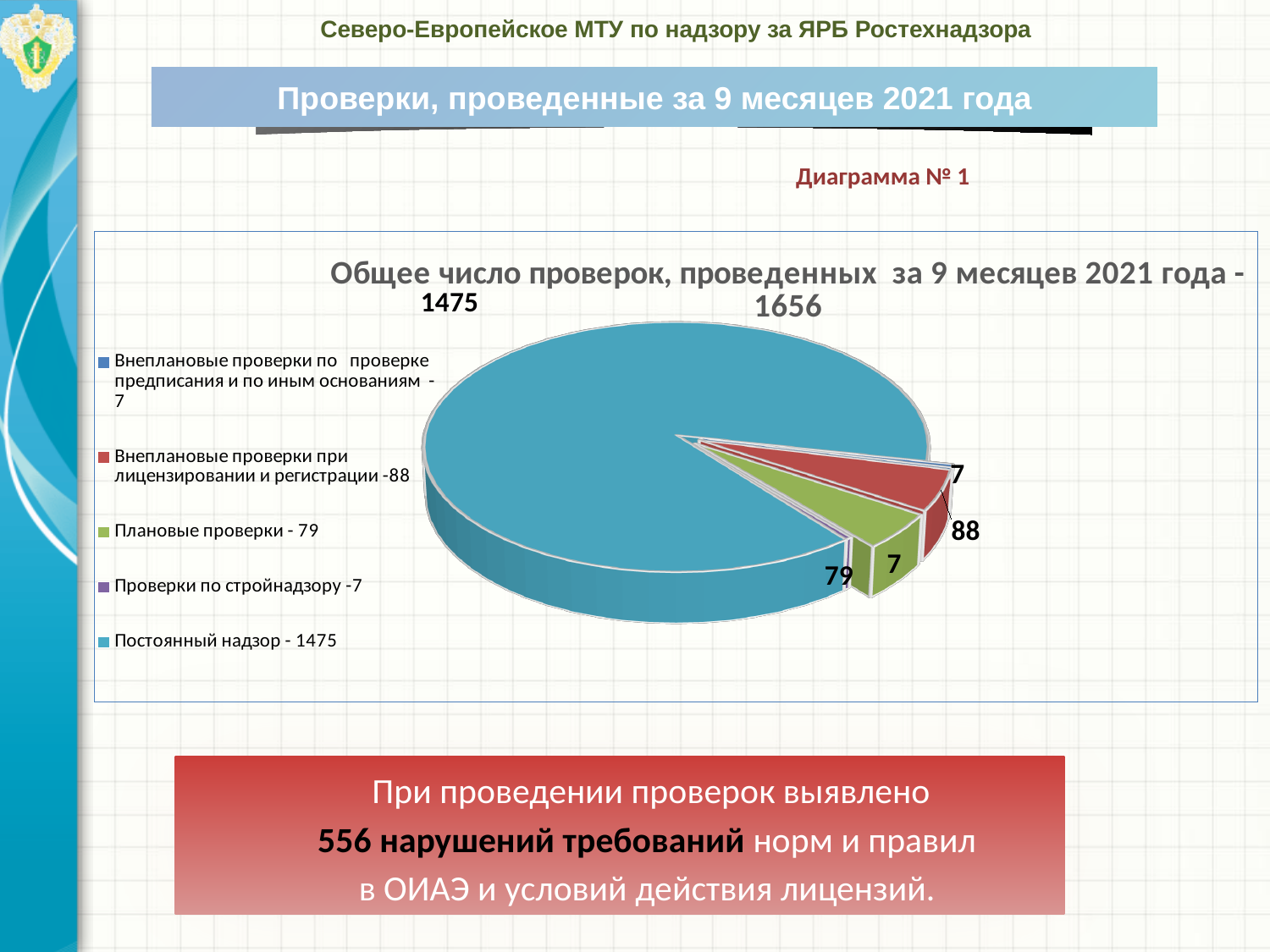
Which category has the largest slice of the pie? Постоянный надзор What is the value for "Внеплановые проверки при лицензировании и регистрации"? 88 What colour is the slice for "Плановые проверки"? Green What is the value for "Постоянный надзор" in the pie chart? 1475 Which is larger: "Плановые проверки" or "Внеплановые проверки при лицензировании и регистрации"? Внеплановые проверки при лицензировании и регистрации What is the difference between the values for "Внеплановые проверки при лицензировании и регистрации" and "Плановые проверки"? 9 What is the value for "Плановые проверки"? 79 What is the difference between the values for "Постоянный надзор" and "Внеплановые проверки при лицензировании и регистрации"? 1387 According to the chart title, what is the total number of inspections conducted over 9 months of 2021? 1656 How many categories does the pie chart legend list? 5 What kind of chart is shown on the slide? Pie chart What is the value for "Проверки по стройнадзору"? 7